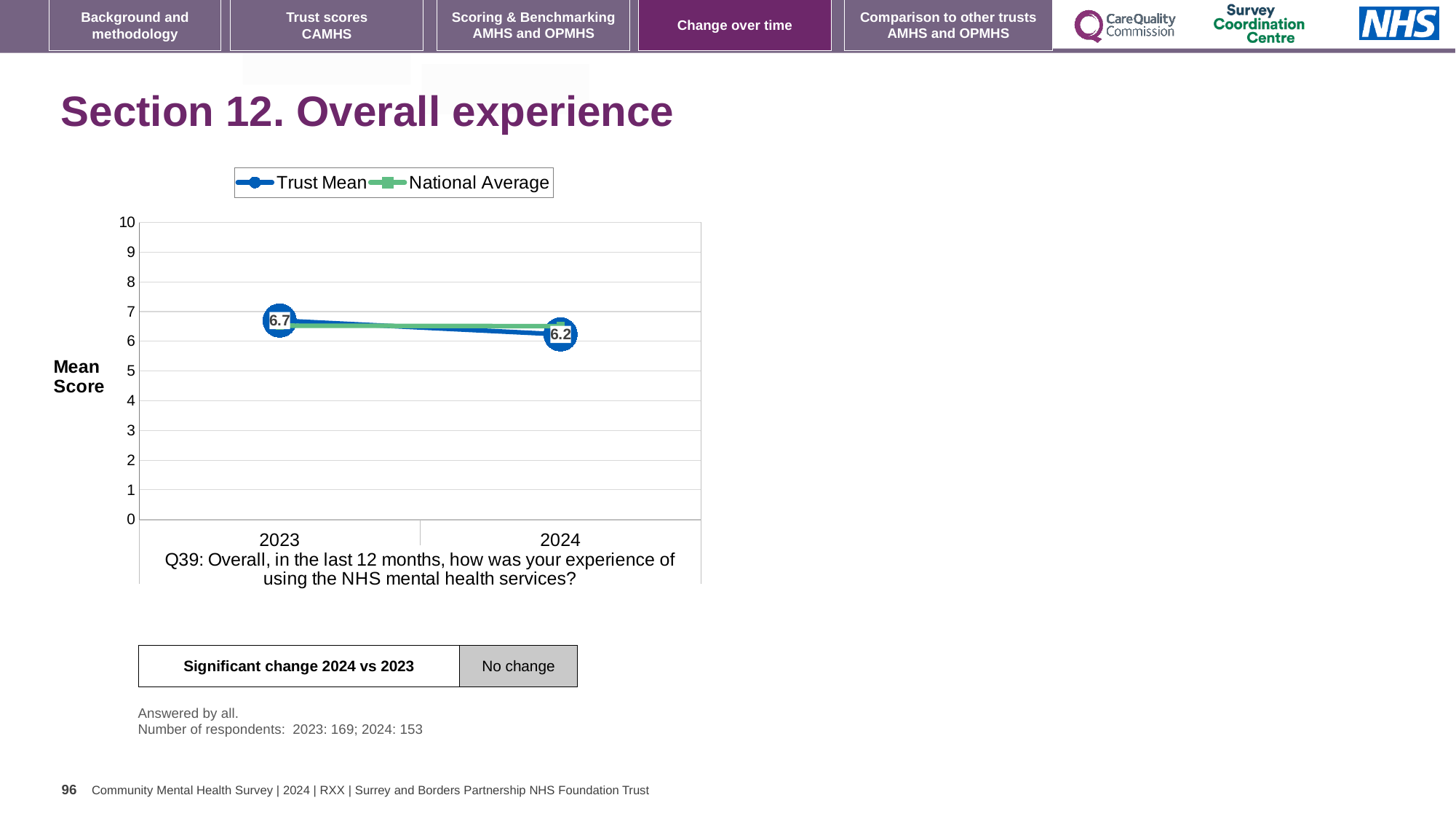
How many years are plotted on the x axis? 2 What kind of chart is shown on the slide? line chart How many series does the legend list? 2 What is the difference between the Trust Mean in 2023 and in 2024? 0.5 In which year is the Trust Mean lowest? 2024 Does the Trust Mean rise or fall from 2023 to 2024? fall Is the National Average value for 2024 greater or less than 7? less Is the National Average value for 2023 greater or less than 6? greater What is the Trust Mean score for 2023? 6.7 Which is larger, the Trust Mean for 2023 or for 2024? 2023 What is the Trust Mean score for 2024? 6.2 In which year is the Trust Mean highest? 2023